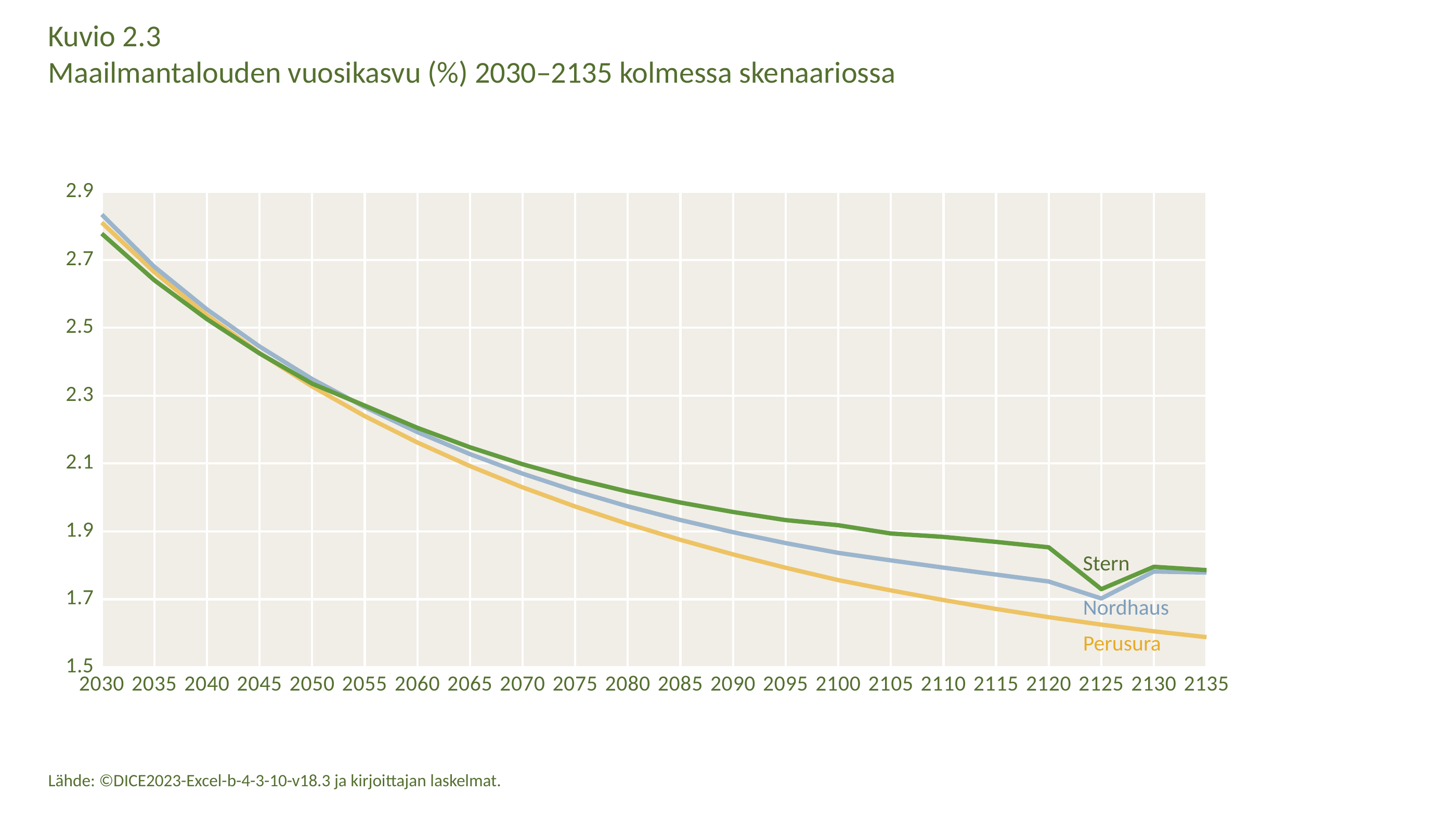
What kind of chart is shown on the slide? line chart How many years are marked on the x axis of the chart? 22 Is the value for Nordhaus in 2060 greater or less than 2.1? greater In 2135, which is larger: the value for Stern or the value for Perusura? Stern How many series (scenarios) are plotted in the chart? 3 Is the value for Stern in 2030 greater or less than 2.7? greater In 2100, which is larger: the value for Nordhaus or the value for Perusura? Nordhaus Is the value for Perusura in 2100 greater or less than 1.9? less Which series has the lowest value in 2135? Perusura Which series is drawn with the green line? Stern Do the values of the Perusura series rise or fall from 2030 to 2135? fall